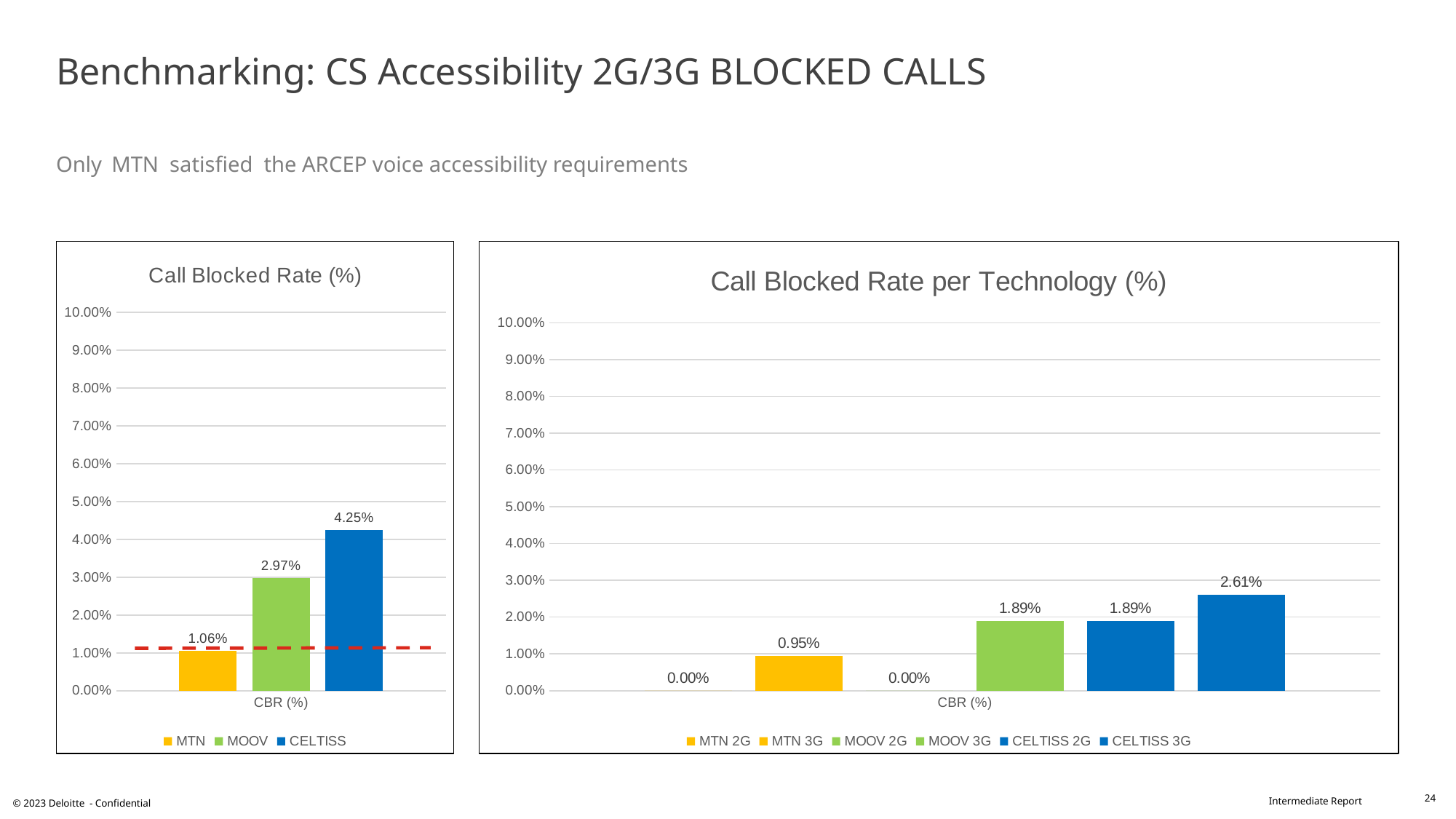
In the 'Call Blocked Rate (%)' chart, what is the value for CELTISS? 4.25% In the 'Call Blocked Rate (%)' chart, which operator has the highest call blocked rate? CELTISS In the 'Call Blocked Rate per Technology (%)' chart, how many series does the legend list? 6 In the 'Call Blocked Rate per Technology (%)' chart, which series has the highest value? CELTISS 3G What kind of chart is the 'Call Blocked Rate per Technology (%)' chart? Bar chart In the 'Call Blocked Rate per Technology (%)' chart, what is the value for MTN 3G? 0.95% In the 'Call Blocked Rate (%)' chart, which operator has the lowest call blocked rate? MTN In the 'Call Blocked Rate per Technology (%)' chart, what is the value for CELTISS 3G? 2.61% In the 'Call Blocked Rate per Technology (%)' chart, what is the value for MOOV 2G? 0.00% In the 'Call Blocked Rate (%)' chart, how many series does the legend list? 3 In the 'Call Blocked Rate (%)' chart, what is the value for MTN? 1.06% In the 'Call Blocked Rate (%)' chart, what is the difference between the CELTISS and MOOV values? 1.28%